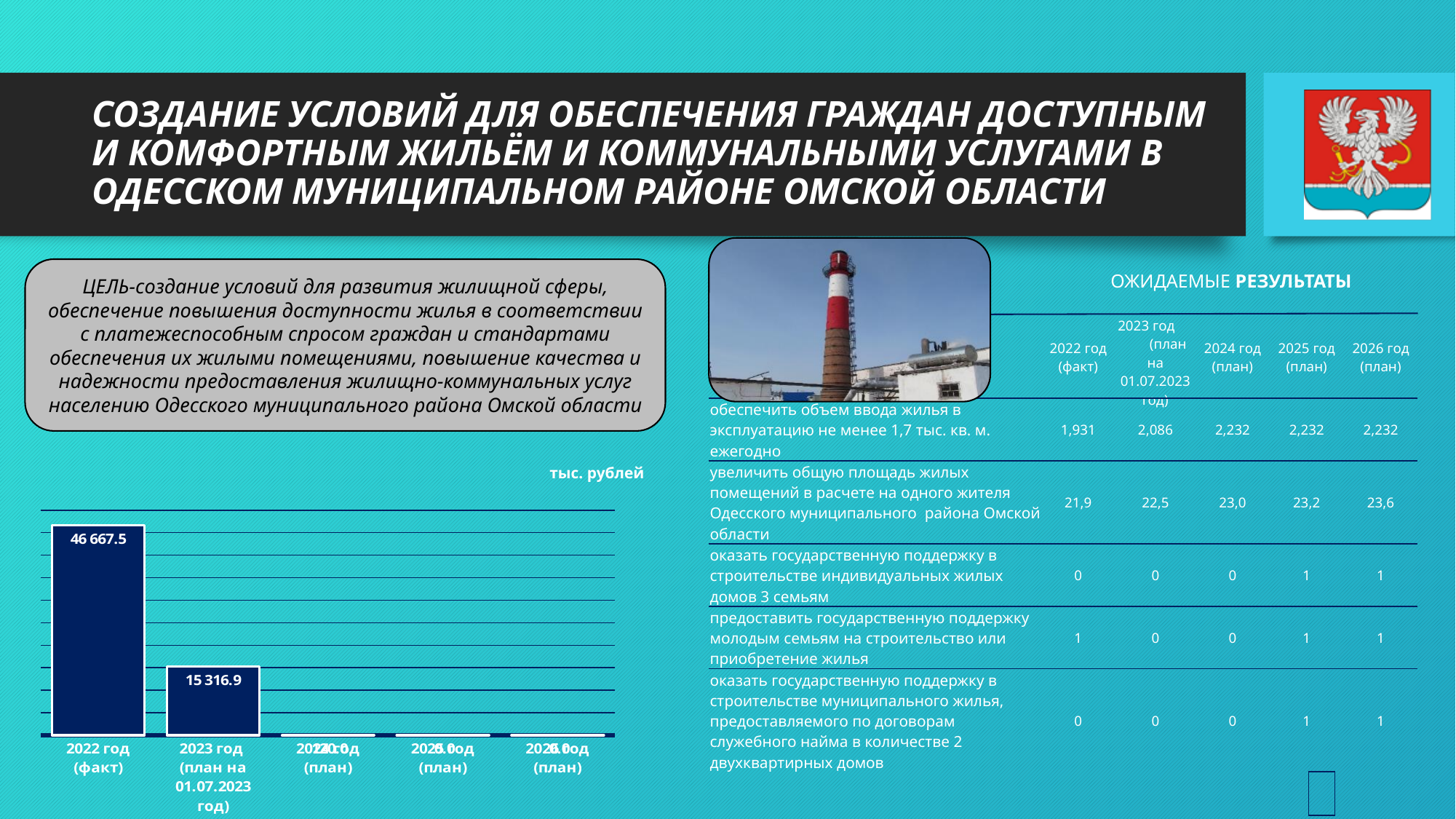
How many categories are shown on the x axis of the bar chart? 5 Which category has the highest value in the bar chart? 2022 год (факт) What is the value for 2022 год (факт) in the bar chart? 46 667.5 What is the value for 2023 год (план на 01.07.2023 год) in the bar chart? 15 316.9 What unit is indicated above the bar chart? тыс. рублей Do the values in the bar chart rise or fall from 2022 год (факт) to 2023 год (план на 01.07.2023 год)? fall What is the difference between the values for 2022 год (факт) and 2023 год (план на 01.07.2023 год) in the bar chart? 31 350.6 Is the value for 2023 год (план на 01.07.2023 год) in the bar chart greater or less than the value for 2022 год (факт)? less What kind of chart is shown on the left of the slide? bar chart Which is larger in the bar chart: the value for 2022 год (факт) or the value for 2023 год (план на 01.07.2023 год)? 2022 год (факт)